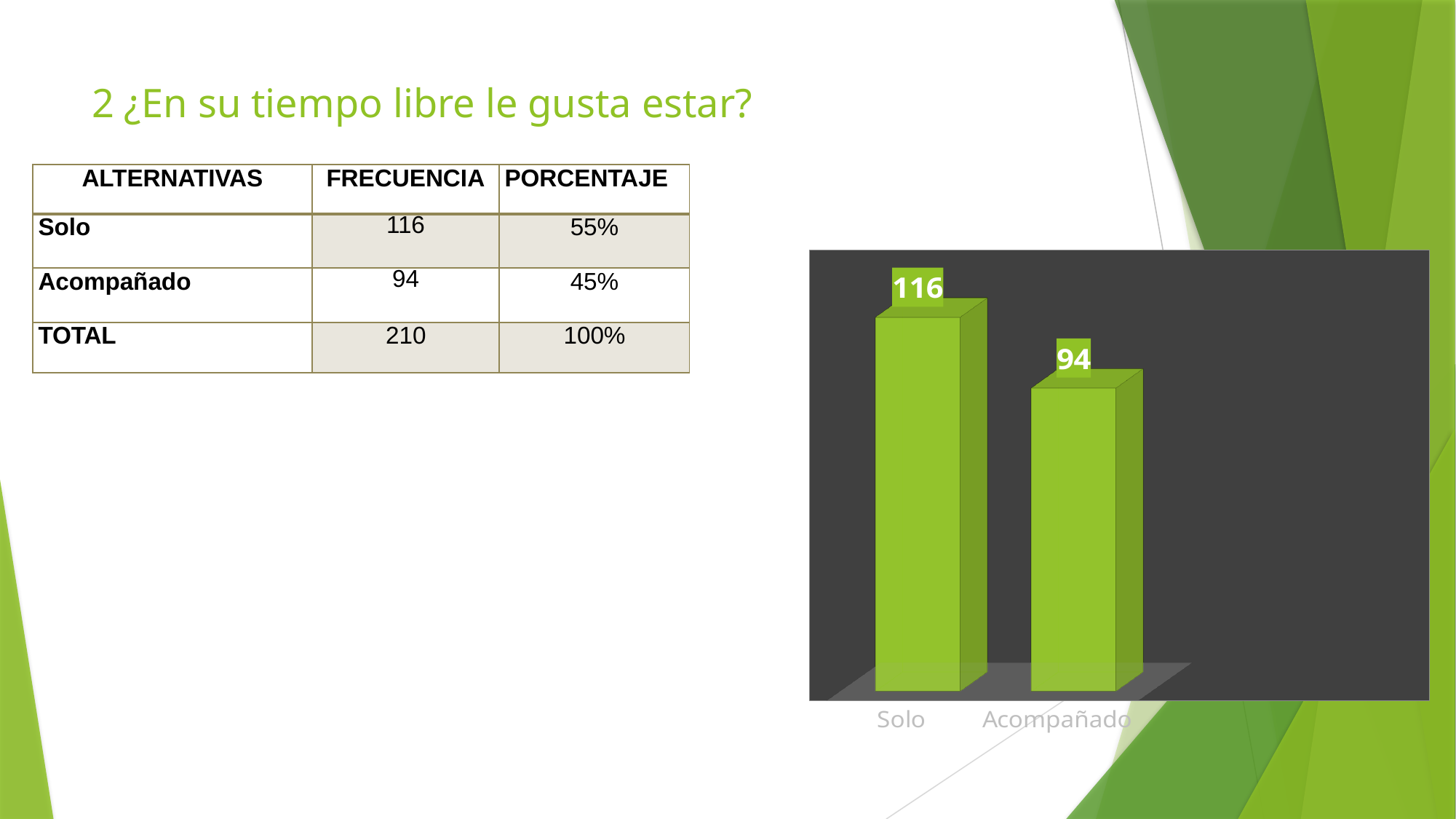
What is the difference between the values for Solo and Acompañado in the chart? 22 How many categories are plotted in the chart? 2 What colour are the bars in the chart? Green Which is larger in the chart, the value for Solo or the value for Acompañado? Solo What is the background colour of the chart's plot area? Dark grey Which category has the lowest bar in the chart? Acompañado What is the total of the two bar values in the chart? 210 What is the value shown for Solo in the chart? 116 What kind of chart is shown on the slide? Bar chart What is the value shown for Acompañado in the chart? 94 Which category has the highest bar in the chart? Solo Do the bar values rise or fall from Solo to Acompañado? Fall